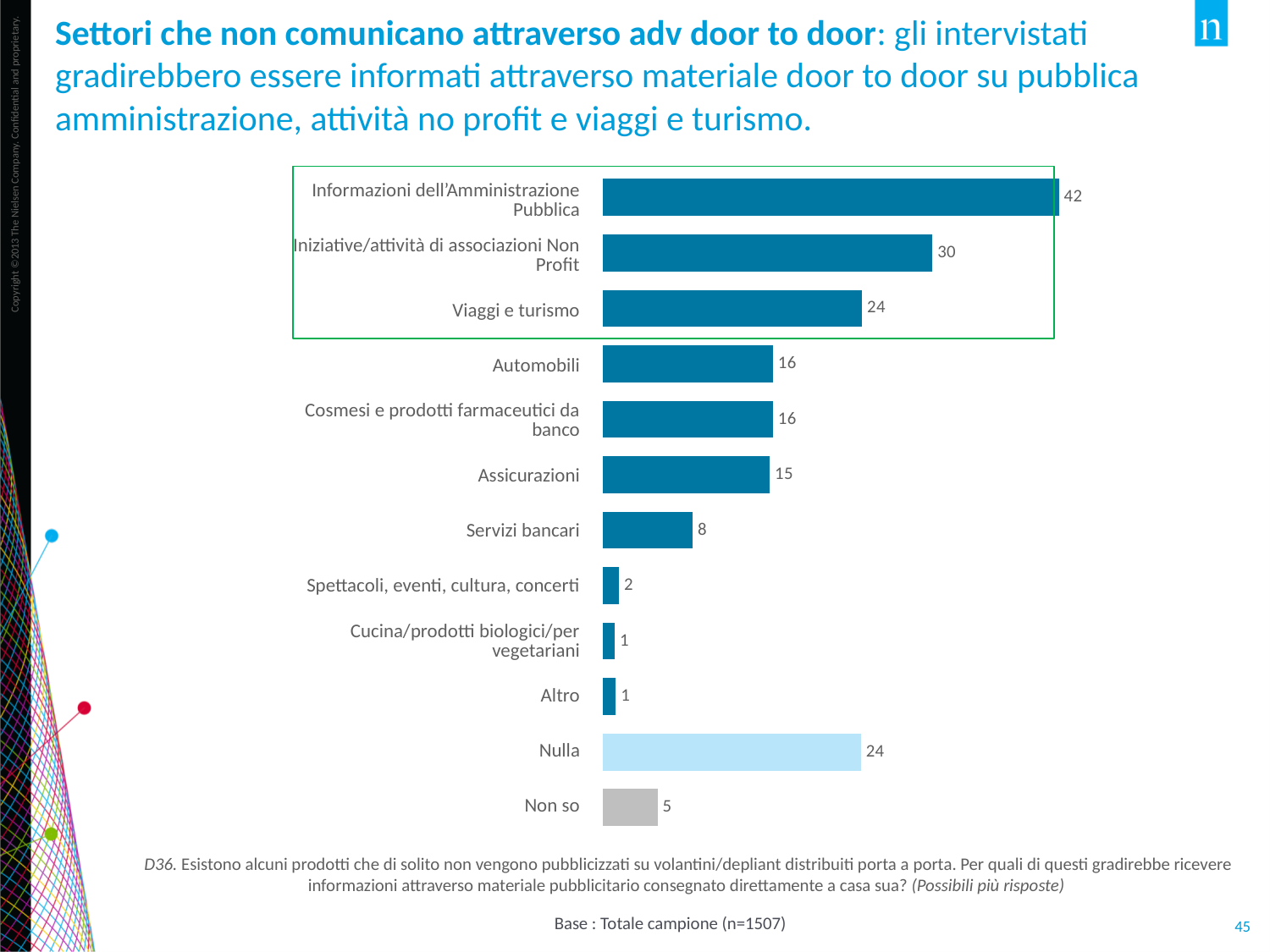
What is the difference between the values for Nulla and Non so? 19 How many categories are shown in the chart? 12 What is the value for Non so? 5 What is the value for Informazioni dell'Amministrazione Pubblica? 42 What is the value for Viaggi e turismo? 24 What kind of chart is shown on the slide? Bar chart What is the value for Cosmesi e prodotti farmaceutici da banco? 16 What is the difference between the values for Informazioni dell'Amministrazione Pubblica and Iniziative/attività di associazioni Non Profit? 12 Which category has the highest value? Informazioni dell'Amministrazione Pubblica Which is larger, the value for Assicurazioni or the value for Servizi bancari? Assicurazioni What is the value for Servizi bancari? 8 Which is larger, the value for Automobili or the value for Spettacoli, eventi, cultura, concerti? Automobili